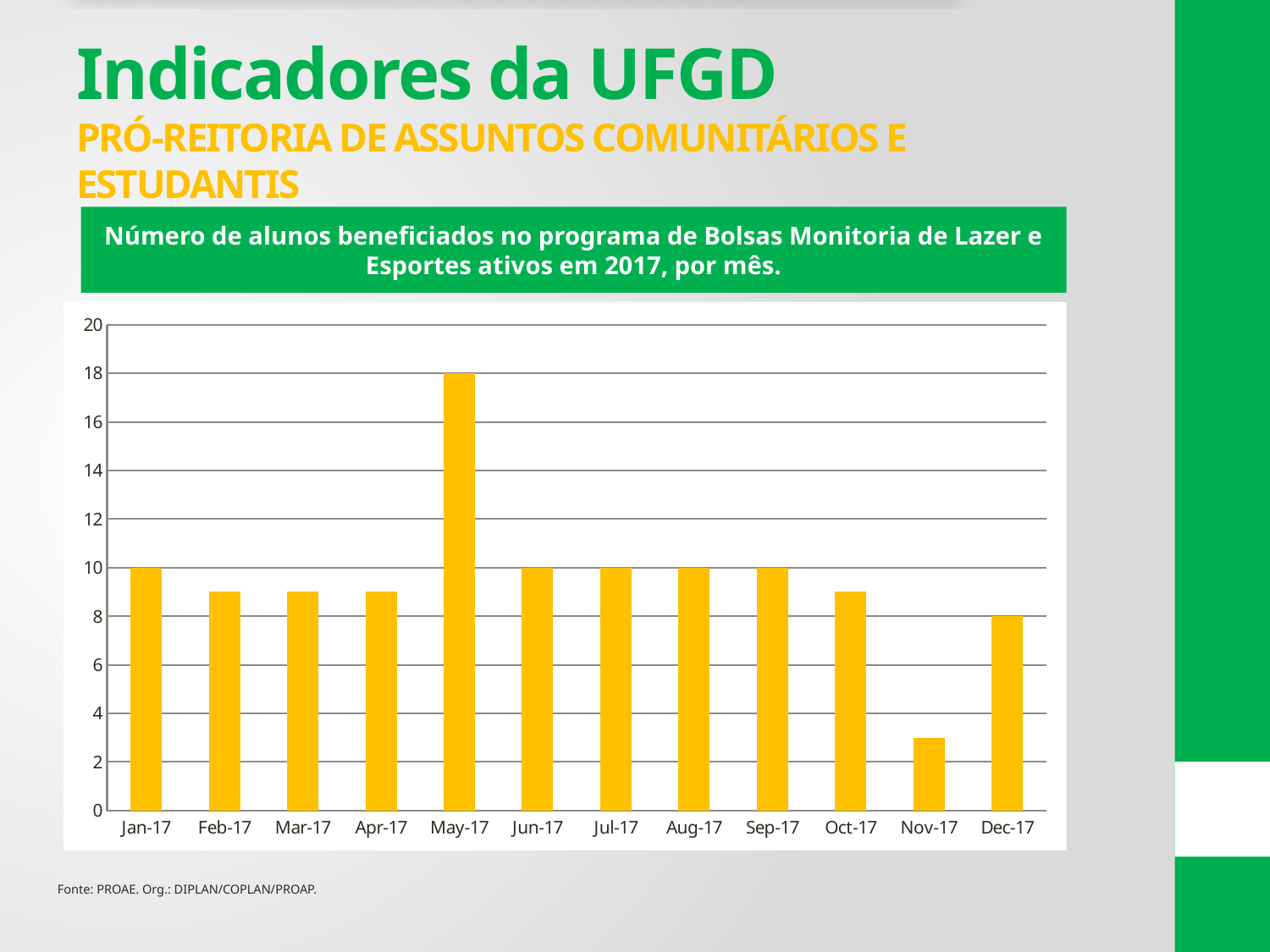
Which month has the highest number of students benefited? May-17 What is the value for Jan-17? 10 Which is larger, the value for Aug-17 or the value for Nov-17? Aug-17 Which month has the lowest number of students benefited? Nov-17 What type of chart is shown on the slide? Bar chart What is the value for Dec-17? 8 How many months are plotted on the x axis of the chart? 12 What colour are the bars in the chart? Yellow What is the difference between the values for May-17 and Dec-17? 10 Is the value for Nov-17 greater or less than 4? less What is the value for May-17? 18 Is the value for Feb-17 greater or less than 8? greater